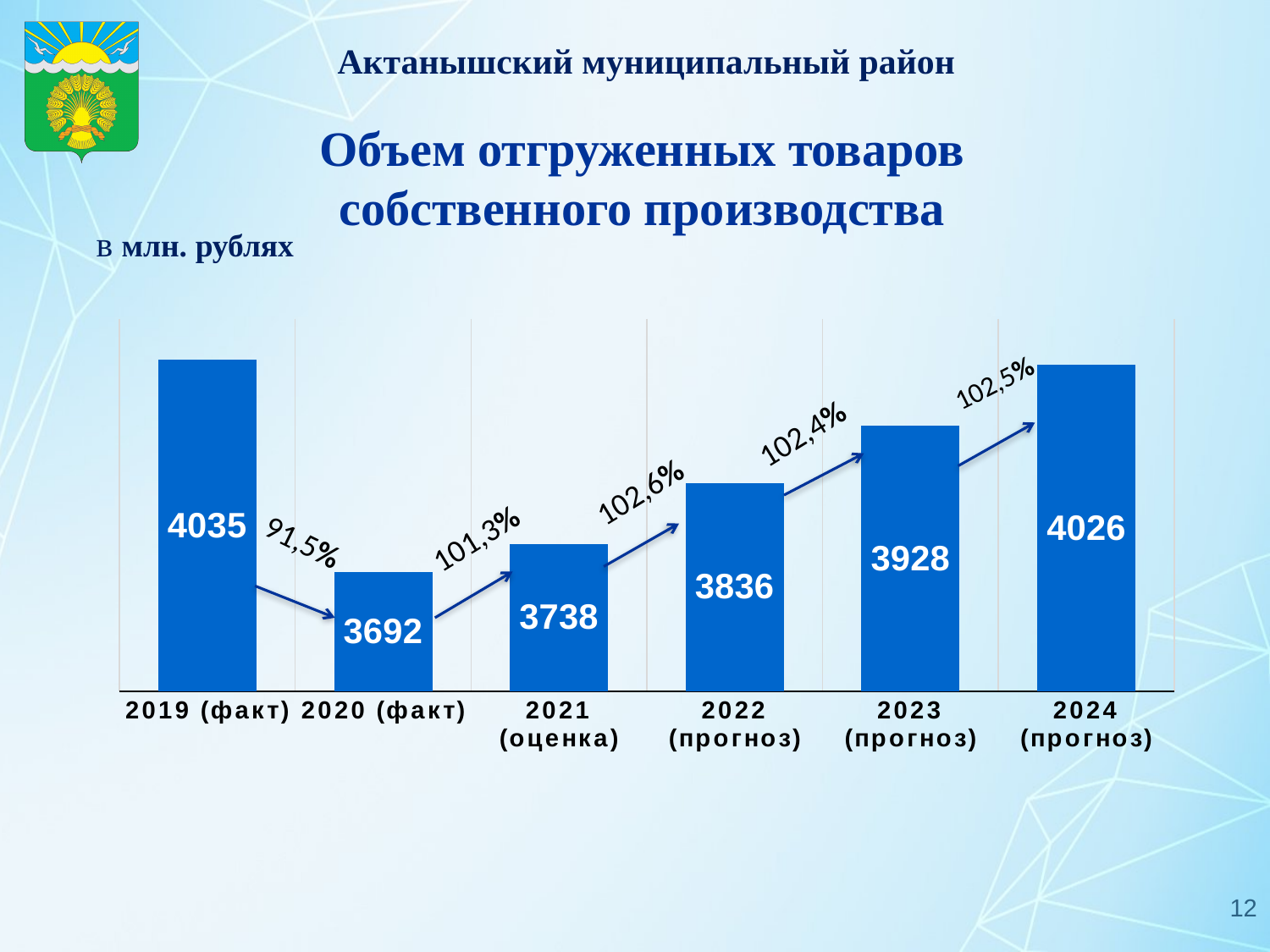
Which category has the lowest value? 2020 (факт) What is the value for 2024 (прогноз)? 4026 What is the difference between the values for 2024 (прогноз) and 2023 (прогноз)? 98 What kind of chart is shown on the slide? bar chart What percentage is shown on the arrow between 2019 (факт) and 2020 (факт)? 91,5% What is the value for 2019 (факт)? 4035 How many categories are shown on the x axis? 6 Which is larger, the value for 2021 (оценка) or the value for 2022 (прогноз)? 2022 (прогноз) Do the values rise or fall from 2020 (факт) to 2024 (прогноз)? rise What is the value for 2022 (прогноз)? 3836 Which category has the highest value? 2019 (факт) What is the difference between the values for 2019 (факт) and 2020 (факт)? 343